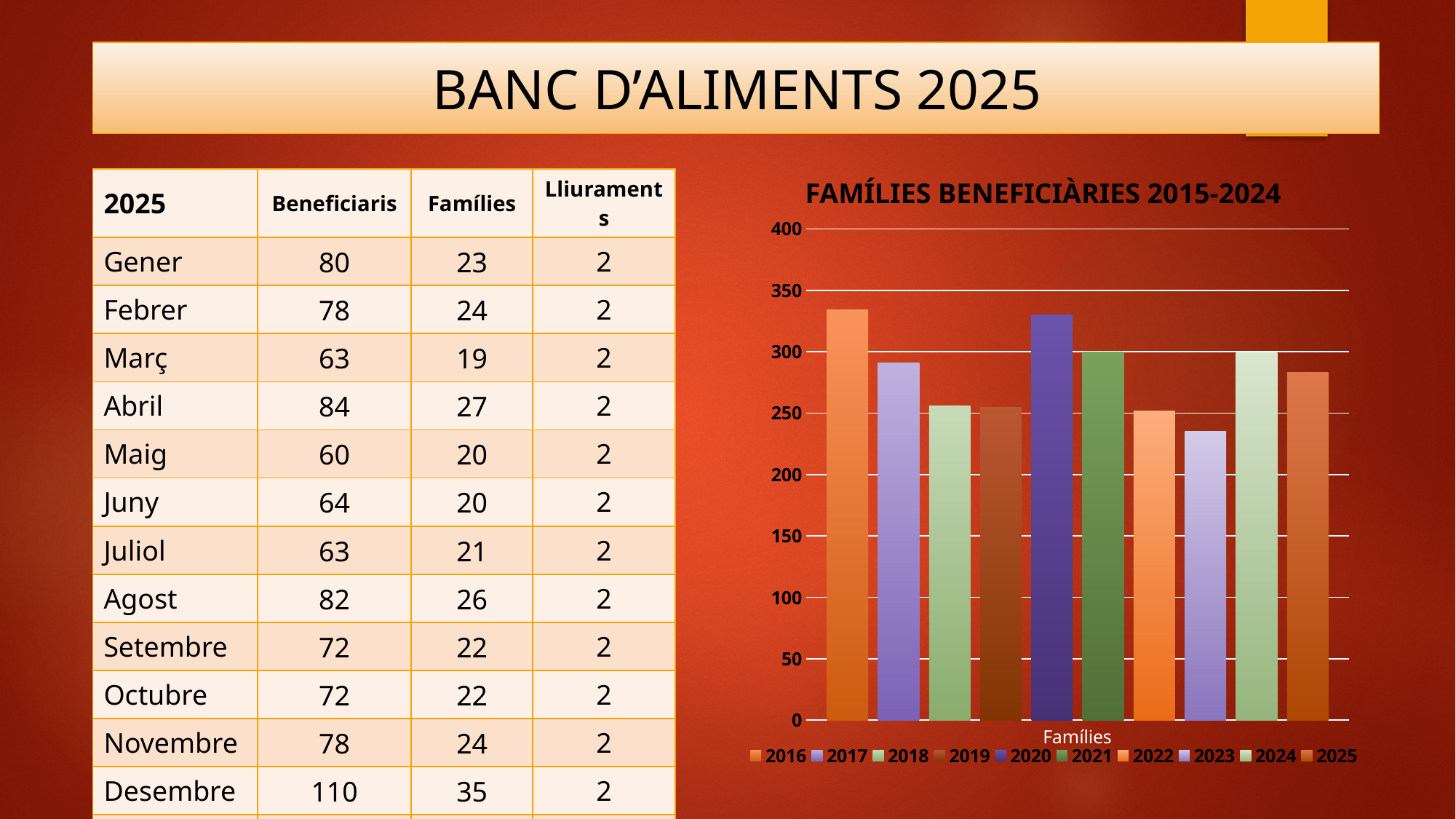
Which is larger, the value for 2020 or the value for 2018? 2020 Is the value for 2023 greater or less than 250? less Which is larger, the value for 2016 or the value for 2023? 2016 Is the value for 2020 greater or less than 300? greater What is the label of the category on the chart's x axis? Famílies How many categories are shown on the chart's x axis? 1 Is the value for 2016 greater or less than 300? greater How many series does the chart's legend list? 10 What kind of chart is shown on the slide? bar chart Which year has the lowest bar in the chart? 2023 What is the title of the chart? FAMÍLIES BENEFICIÀRIES 2015-2024